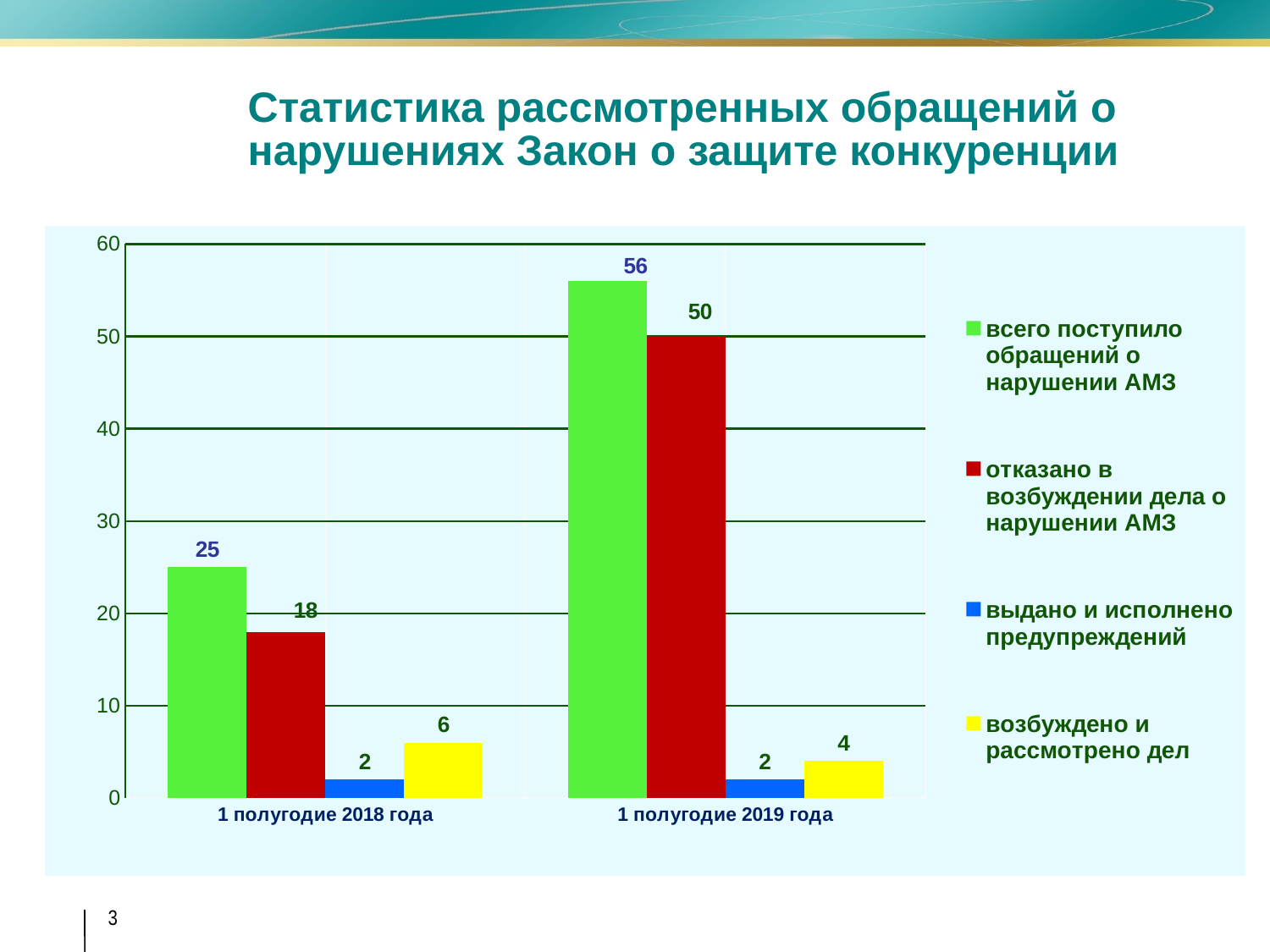
How many categories are shown on the x axis? 2 Which series has the highest value in 1 полугодие 2019 года? всего поступило обращений о нарушении АМЗ What is the difference between 'всего поступило обращений о нарушении АМЗ' in 1 полугодие 2019 года and in 1 полугодие 2018 года? 31 How many series does the legend list? 4 Which is larger: 'отказано в возбуждении дела о нарушении АМЗ' in 1 полугодие 2018 года or in 1 полугодие 2019 года? 1 полугодие 2019 года What is the value for 'отказано в возбуждении дела о нарушении АМЗ' in 1 полугодие 2018 года? 18 What kind of chart is shown on the slide? bar chart Which series has the lowest value in 1 полугодие 2018 года? выдано и исполнено предупреждений What is the value for 'выдано и исполнено предупреждений' in 1 полугодие 2019 года? 2 Is the value for 'отказано в возбуждении дела о нарушении АМЗ' in 1 полугодие 2019 года greater or less than 40? greater What is the value for 'возбуждено и рассмотрено дел' in 1 полугодие 2018 года? 6 What is the value for 'всего поступило обращений о нарушении АМЗ' in 1 полугодие 2019 года? 56